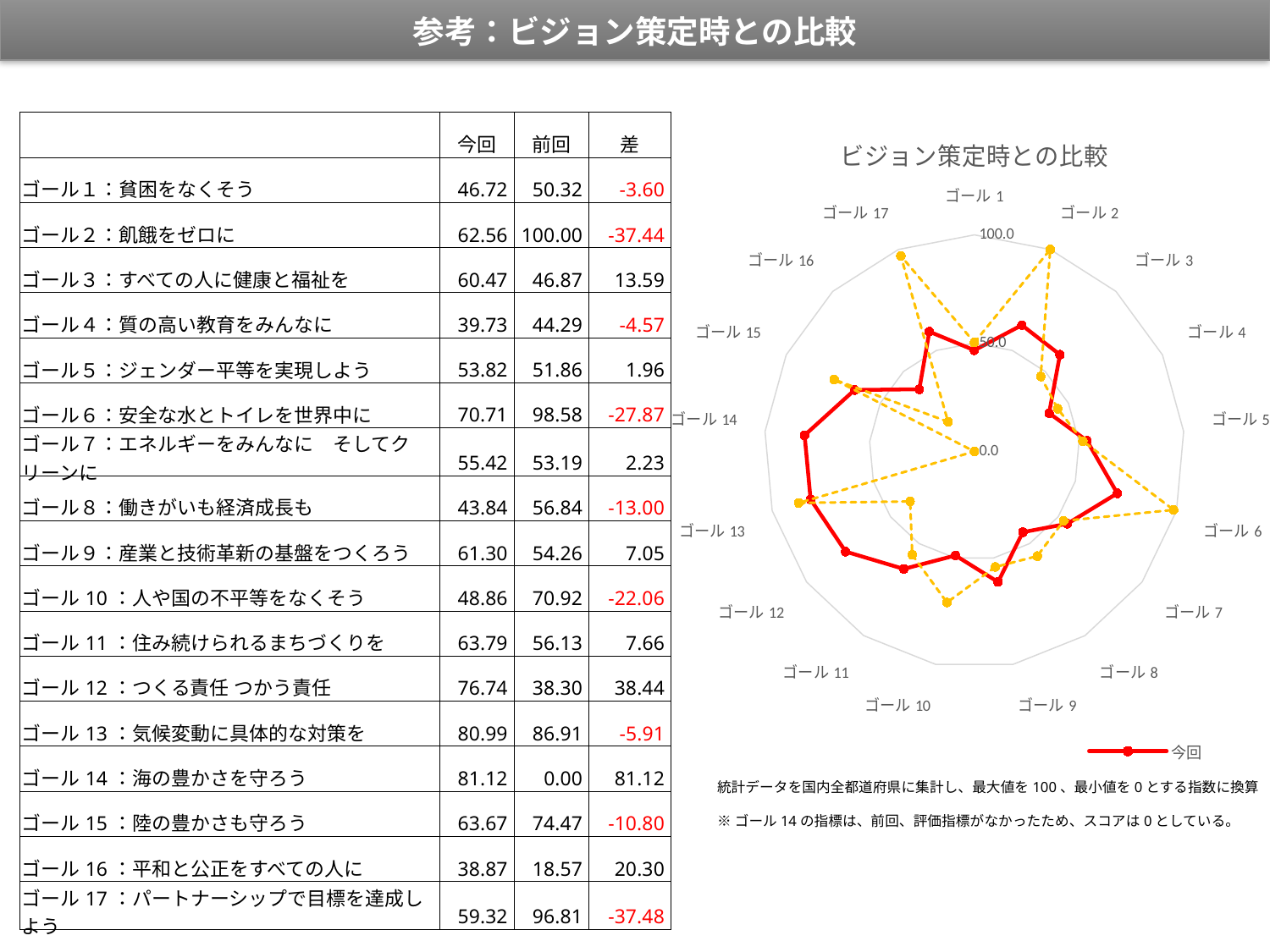
What is the title of the chart? ビジョン策定時との比較 Is the 今回 value for ゴール 16 greater or less than 50.0? less Is the 今回 value for ゴール 14 greater or less than 50.0? greater For ゴール 2, which is larger: the 今回 value or the 前回 value? 前回 According to the table, what is the 前回 value for ゴール 14? 0.00 What is the maximum value shown on the radar chart's axis? 100.0 According to the table, what is the difference (差) between 今回 and 前回 for ゴール 2? -37.44 What kind of chart is shown on the slide? radar chart Is the 前回 value for ゴール 2 greater or less than 50.0? greater How many categories (goals) are plotted around the radar chart? 17 According to the table, what is the 今回 value for ゴール 12? 76.74 For ゴール 12, which is larger: the 今回 value or the 前回 value? 今回